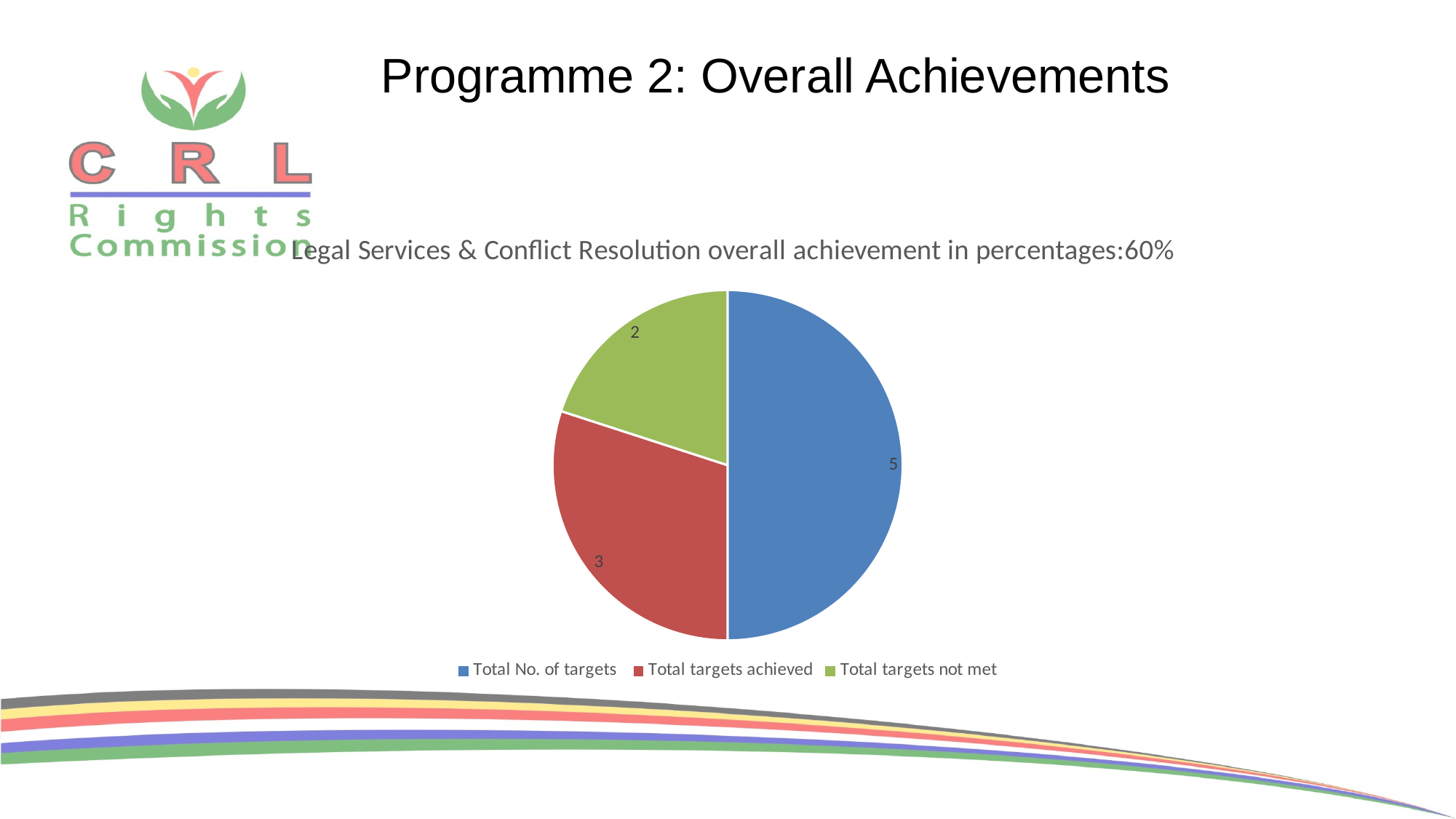
How many slices does the pie chart have? 3 Which category has the largest slice? Total No. of targets What is the value for Total targets not met? 2 What share of the pie does Total No. of targets represent? 50% What is the title of the chart? Legal Services & Conflict Resolution overall achievement in percentages:60% What is the value for Total targets achieved? 3 What is the value for Total No. of targets? 5 Which is larger, Total targets achieved or Total targets not met? Total targets achieved Which category has the smallest slice? Total targets not met What type of chart is shown on the slide? pie chart What is the difference between Total targets achieved and Total targets not met? 1 What is the difference between Total No. of targets and Total targets achieved? 2